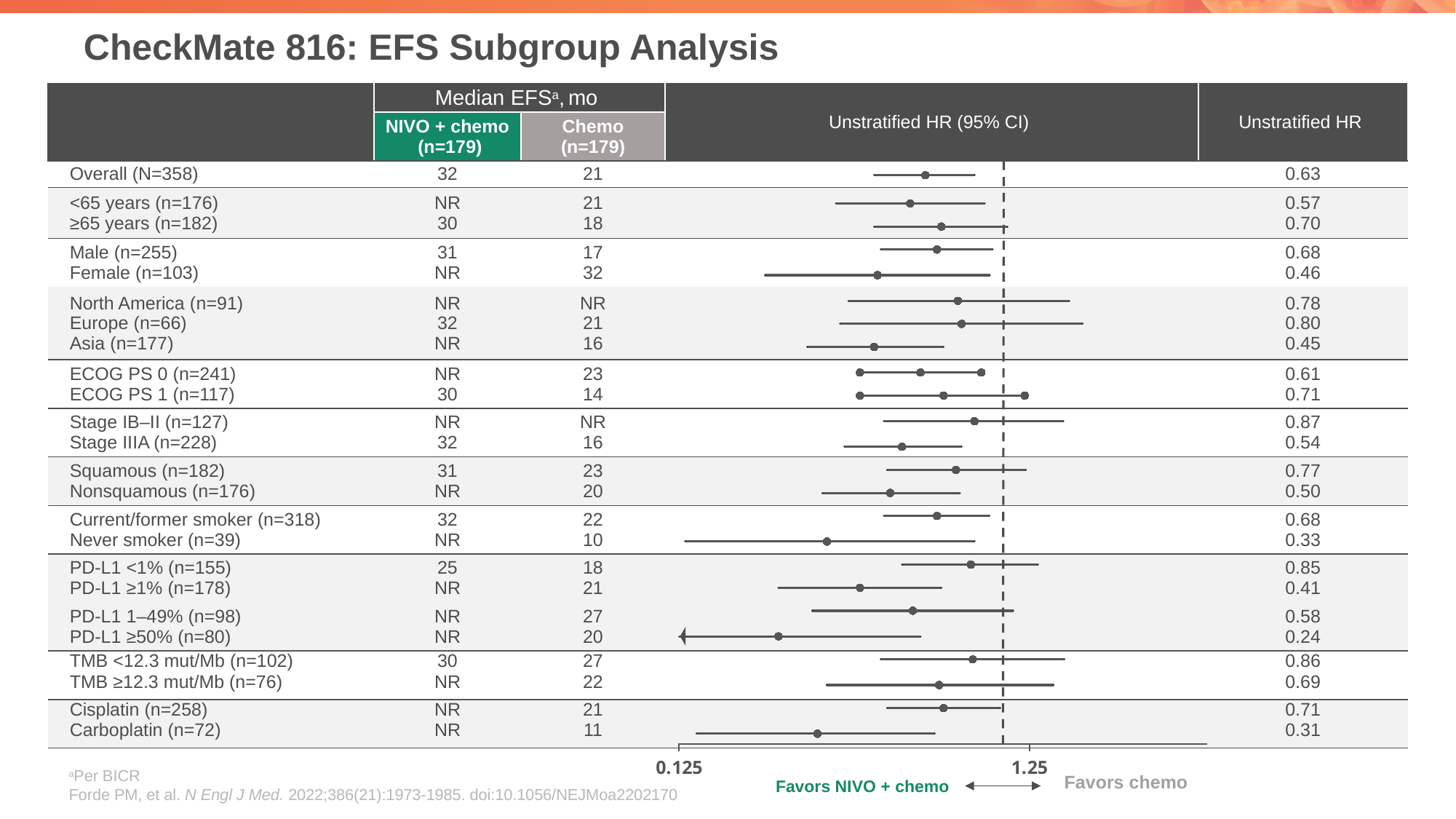
What kind of chart is shown on the slide? Forest plot What is the unstratified HR for the Never smoker (n=39) subgroup? 0.33 What is the unstratified HR for the PD-L1 ≥50% (n=80) subgroup? 0.24 Is the unstratified HR for Carboplatin (n=72) greater or less than 1.25? less How many subgroup points are plotted in the forest plot? 24 What is the unstratified HR for the Overall (N=358) group? 0.63 Which treatment is favored by HR values to the left of the dashed line? NIVO + chemo What are the two tick values labelled on the HR axis? 0.125 and 1.25 Which has the larger unstratified HR, Europe (n=66) or Asia (n=177)? Europe (n=66) What is the difference between the unstratified HR for Male (n=255) and Female (n=103)? 0.22 Which subgroup has the lowest unstratified HR? PD-L1 ≥50% (n=80) What is the median EFS in months for the NIVO + chemo arm in the Overall (N=358) group? 32